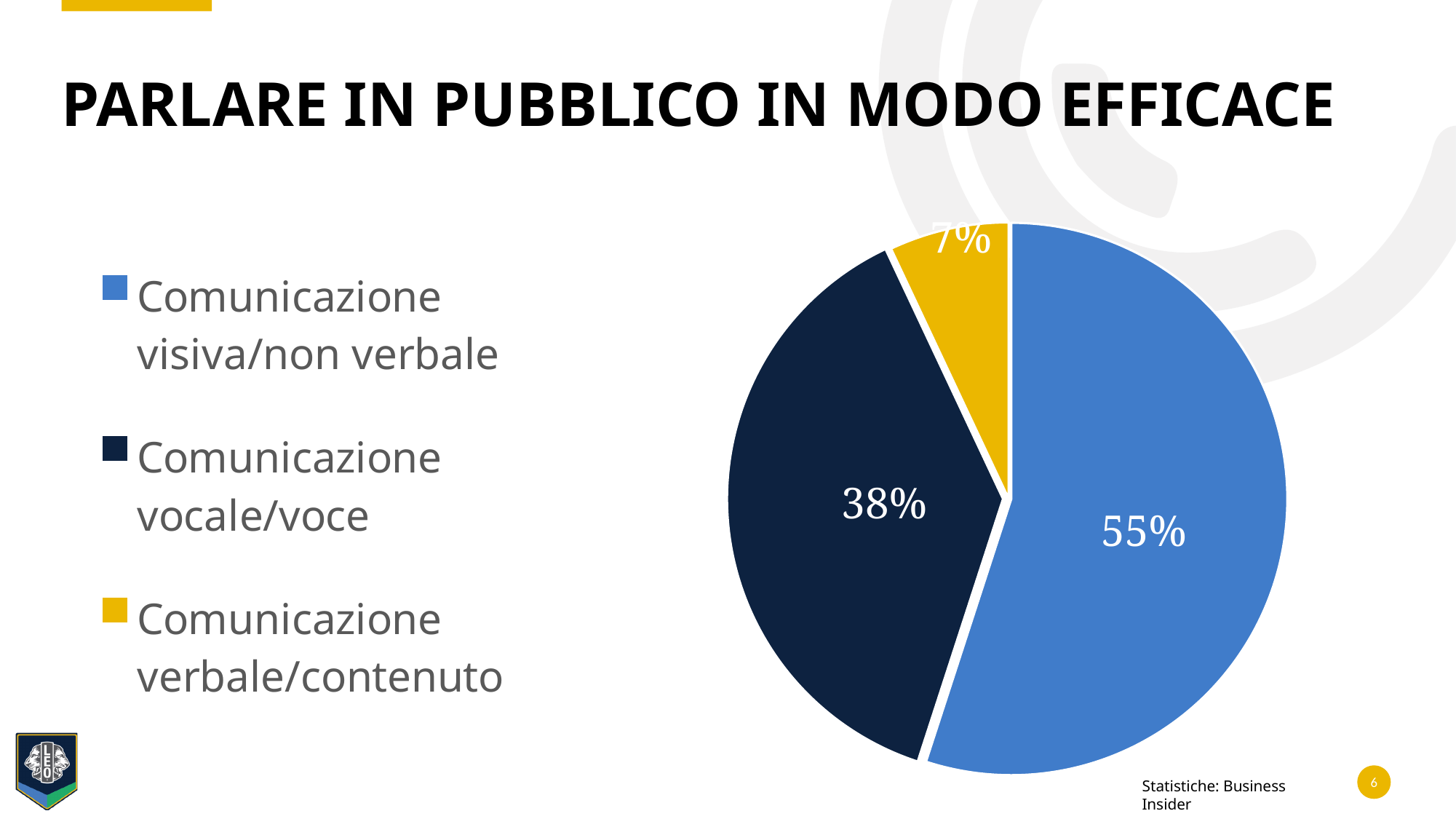
Which category has the smallest slice of the pie? Comunicazione verbale/contenuto Which is larger, the slice for Comunicazione vocale/voce or the slice for Comunicazione verbale/contenuto? Comunicazione vocale/voce What is the title of the slide containing the pie chart? PARLARE IN PUBBLICO IN MODO EFFICACE What is the difference in percentage points between Comunicazione visiva/non verbale and Comunicazione vocale/voce? 17 What percentage is shown for Comunicazione visiva/non verbale? 55% What kind of chart is shown on the slide? pie chart What colour is the slice for Comunicazione verbale/contenuto? yellow What is the difference in percentage points between Comunicazione vocale/voce and Comunicazione verbale/contenuto? 31 Which category has the largest slice of the pie? Comunicazione visiva/non verbale What percentage is shown for Comunicazione vocale/voce? 38% What percentage is shown for Comunicazione verbale/contenuto? 7% How many categories does the pie chart have? 3